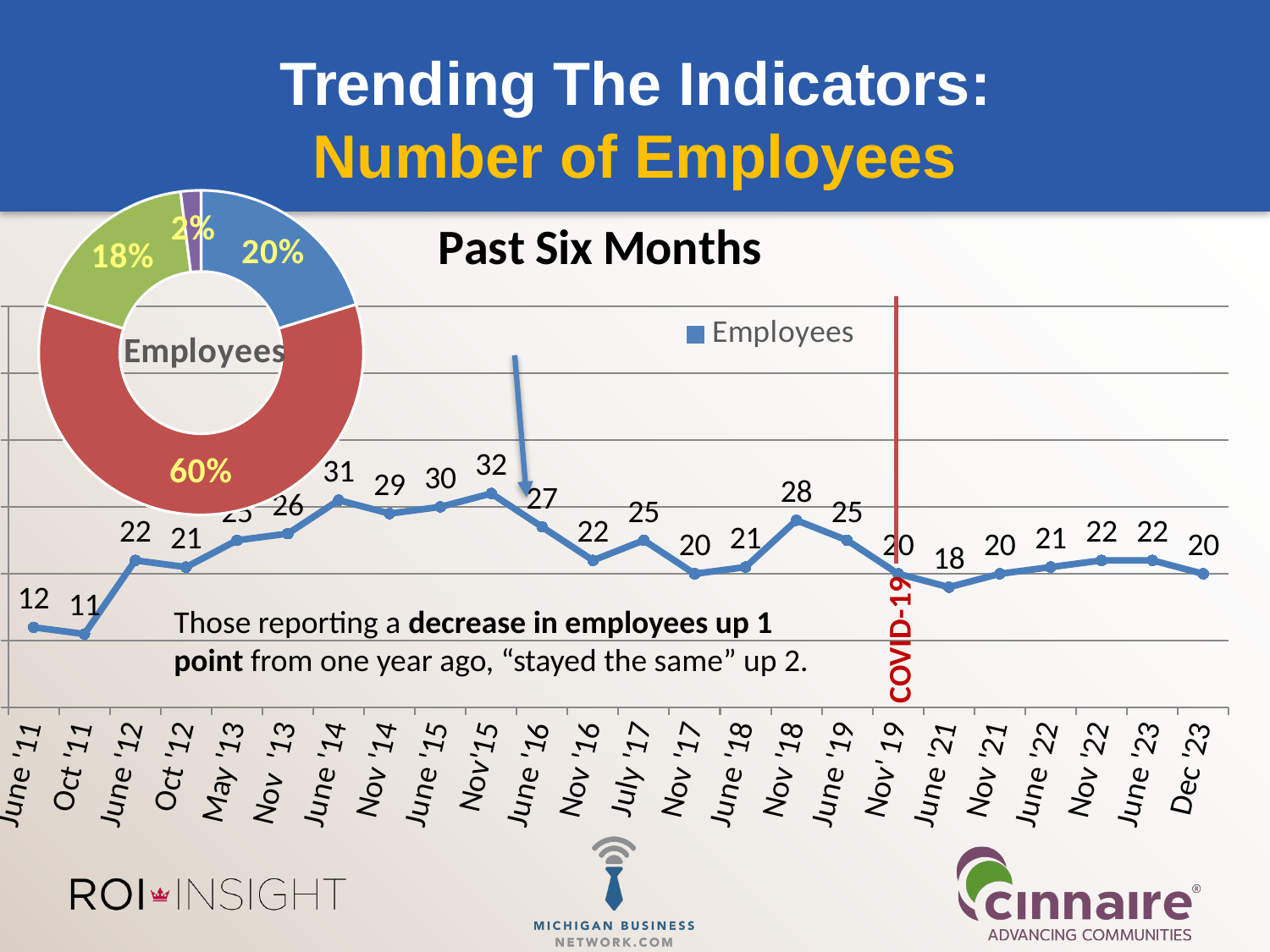
In the doughnut chart, what is the share of the largest slice? 60% What kind of chart is the chart in the top-left corner of the slide? Doughnut chart How many series does the legend of the line chart list? 1 In the line chart, which date has the lowest value? Oct '11 In the line chart, which is larger, the value for June '14 or the value for June '16? June '14 In the line chart, what is the value for Nov '15? 32 In the line chart, which date has the highest value? Nov '15 In the line chart, what is the value for June '21? 18 In the doughnut chart, what is the share of the smallest slice? 2% How many data points are plotted in the line chart? 24 In the line chart, what is the value for Dec '23? 20 In the line chart, what is the difference between the values for Nov '18 and Nov '19? 8